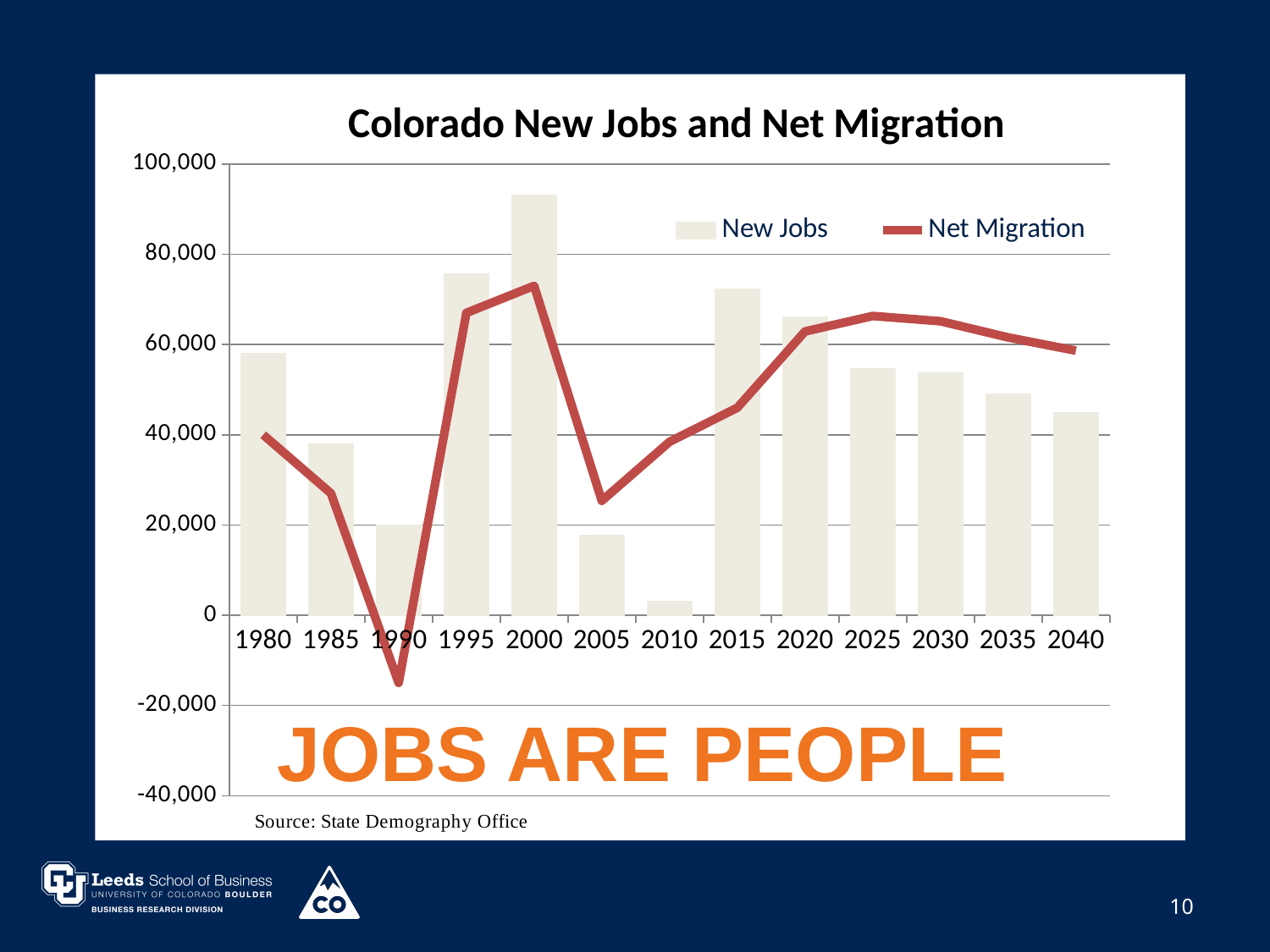
How many series does the legend list? 2 Is the New Jobs value for 2000 greater or less than 80,000? greater How many years are shown along the x axis? 13 Which is larger in 2025, New Jobs or Net Migration? Net Migration In which year is the New Jobs bar the lowest? 2010 What kind of chart is used to show the New Jobs series? Bar chart Do the New Jobs bars rise or fall from 2025 to 2040? Fall Is the New Jobs value for 2010 greater or less than 20,000? less In which year is Net Migration at its lowest? 1990 Is the Net Migration value for 1990 greater or less than 0? less What is the title of the chart? Colorado New Jobs and Net Migration In which year is the New Jobs bar the highest? 2000